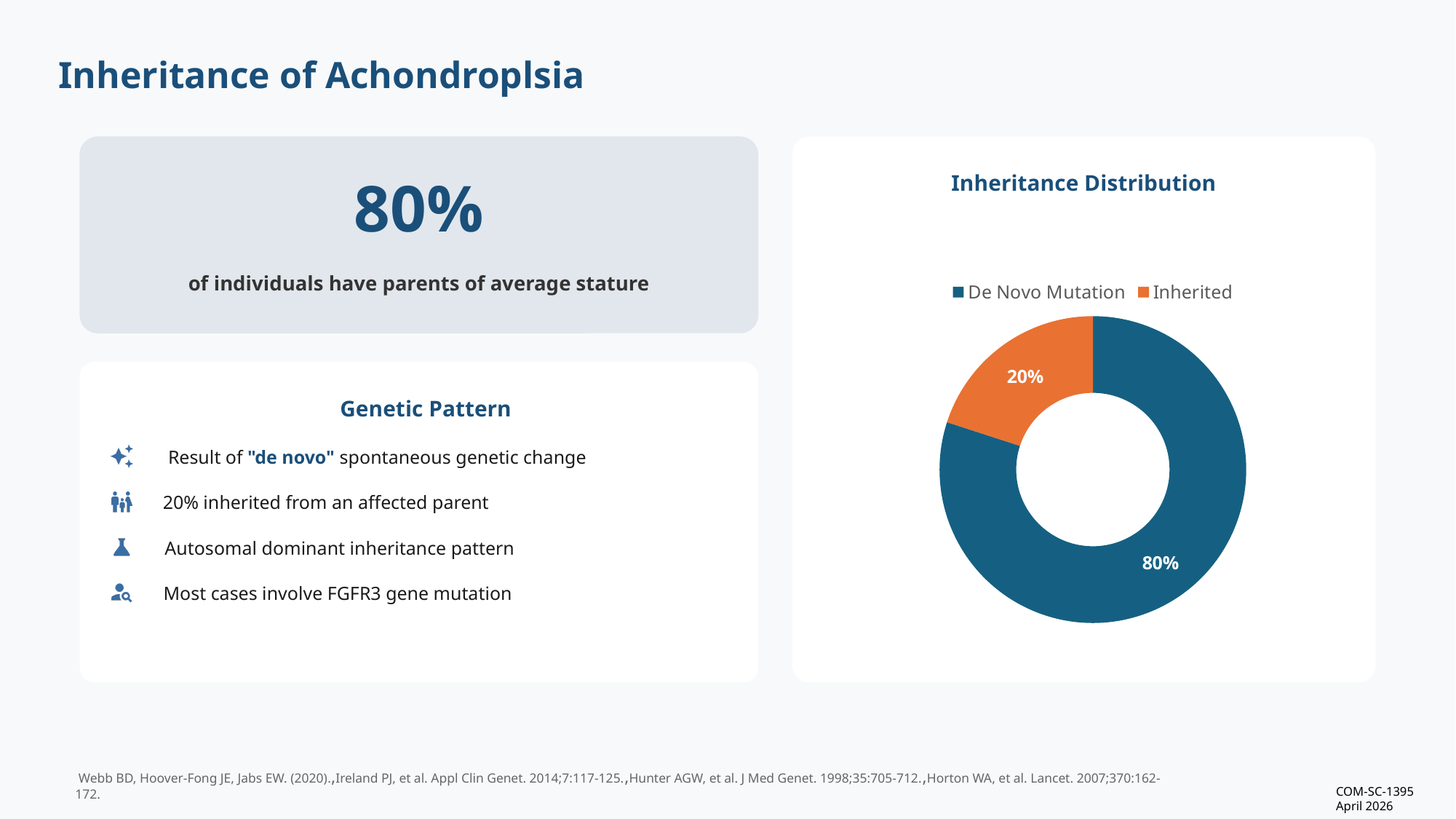
How many categories does the chart show? 2 What percentage does the Inherited slice show? 20% Which is larger, the De Novo Mutation slice or the Inherited slice? De Novo Mutation What is the difference in percentage points between the De Novo Mutation and Inherited slices? 60 What is the title of the chart on the slide? Inheritance Distribution Which category has the largest share of the chart? De Novo Mutation What colour is the Inherited slice? Orange What kind of chart is shown under the title "Inheritance Distribution"? Doughnut (pie) chart What share of the chart does the Inherited slice represent? 20% What percentage does the De Novo Mutation slice show? 80% Which category has the smallest share of the chart? Inherited How many entries does the chart legend list? 2